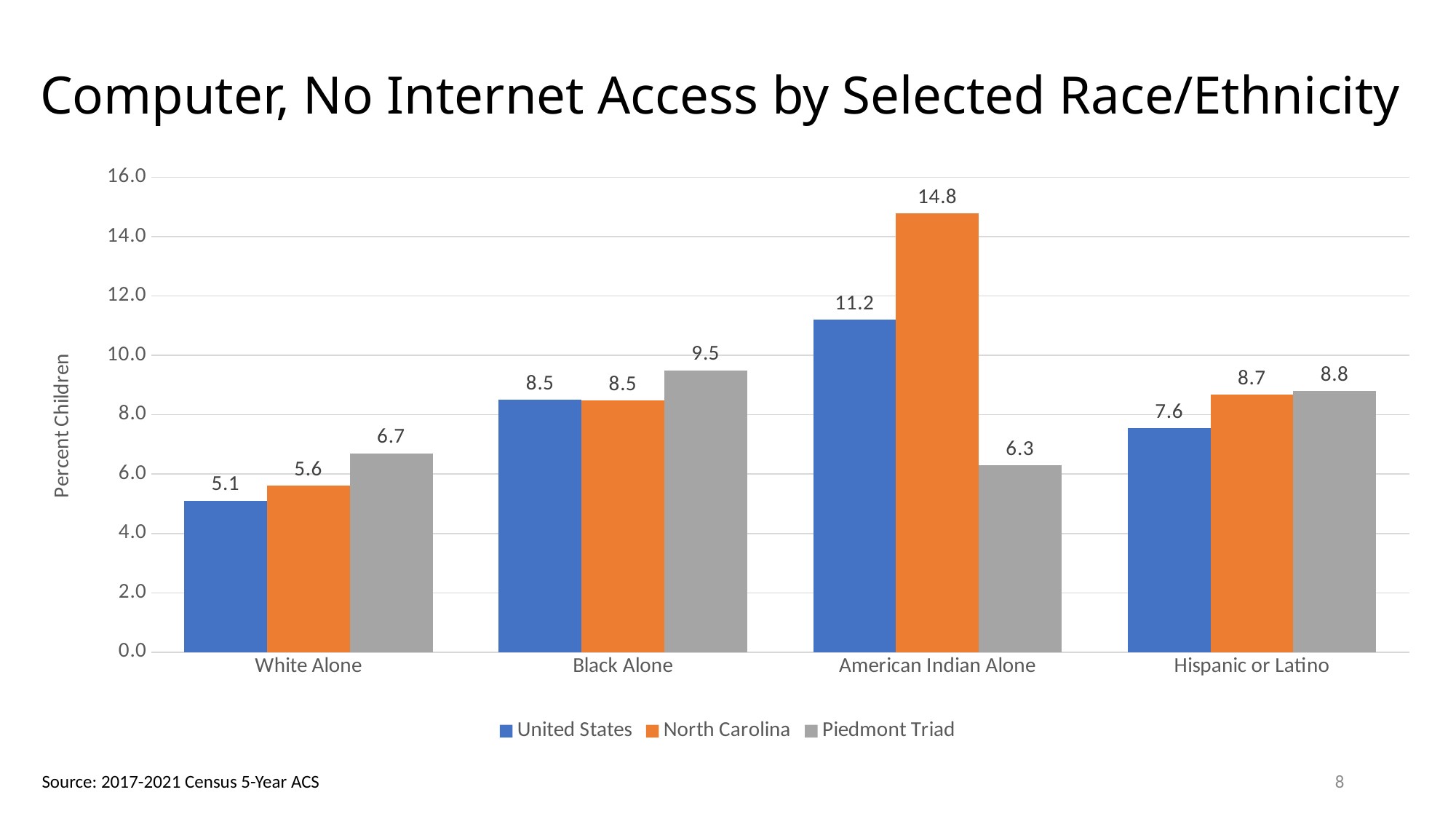
What is the value for Piedmont Triad in the White Alone category? 6.7 Which category has the highest value for the United States series? American Indian Alone How many series does the legend list? 3 Which category has the lowest value for the Piedmont Triad series? American Indian Alone How many race/ethnicity categories are shown on the x axis? 4 Is the value for North Carolina in the American Indian Alone category greater or less than 14.0? greater Which is larger in the Black Alone category: the United States value or the Piedmont Triad value? Piedmont Triad What is the value for North Carolina in the American Indian Alone category? 14.8 What is the value for United States in the Hispanic or Latino category? 7.6 What is the difference between the North Carolina and Piedmont Triad values in the American Indian Alone category? 8.5 What kind of chart is shown on the slide? bar chart What is the label on the vertical axis? Percent Children